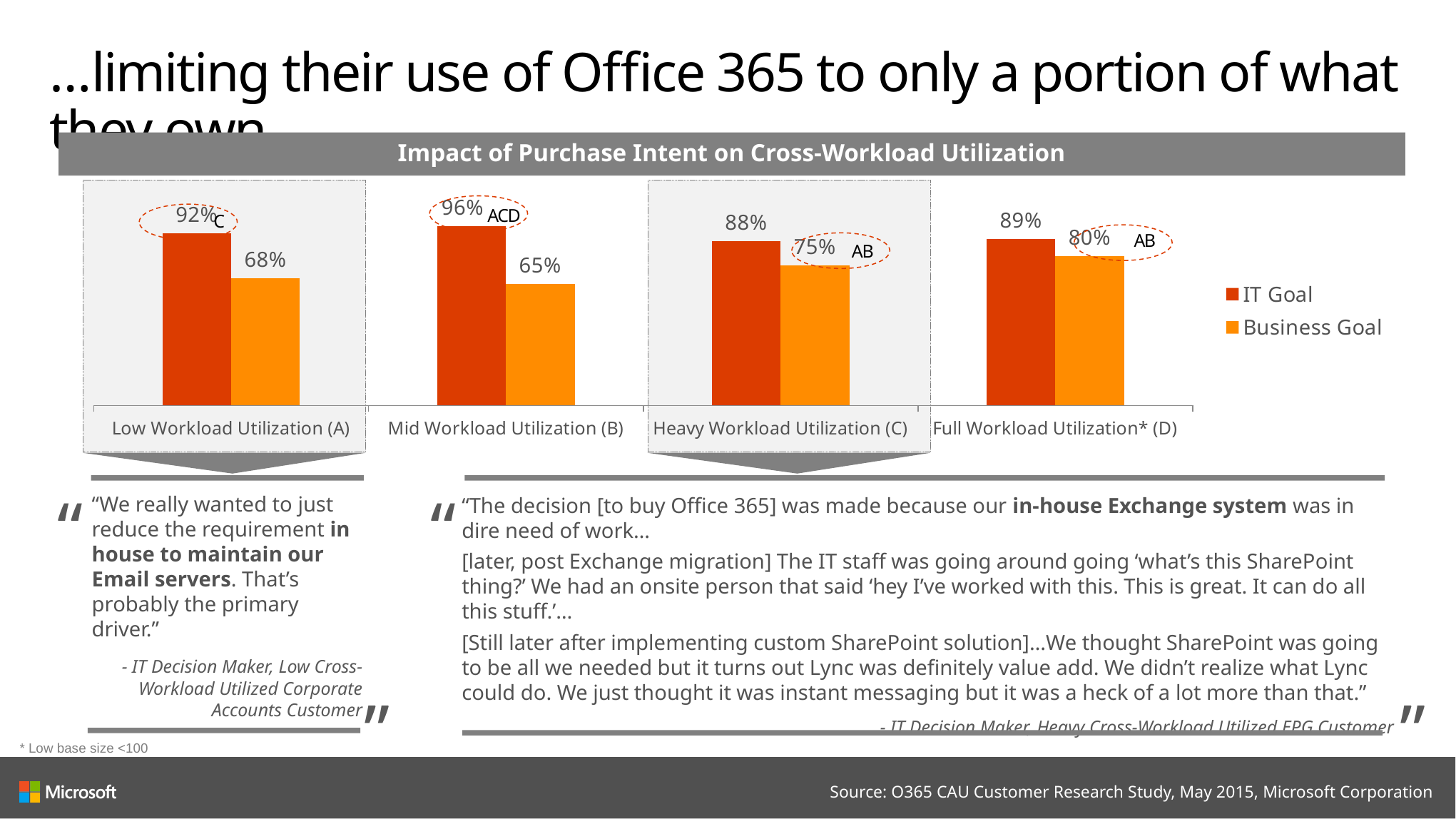
What is the IT Goal value for Low Workload Utilization (A)? 92% How many series does the legend list? 2 Which is larger: the Business Goal value for Full Workload Utilization* (D) or the Business Goal value for Low Workload Utilization (A)? Full Workload Utilization* (D) What is the difference between the IT Goal and Business Goal values for Mid Workload Utilization (B)? 31% What is the title of the chart? Impact of Purchase Intent on Cross-Workload Utilization What is the IT Goal value for Full Workload Utilization* (D)? 89% Which category has the highest IT Goal value? Mid Workload Utilization (B) Which category has the lowest Business Goal value? Mid Workload Utilization (B) What is the Business Goal value for Mid Workload Utilization (B)? 65% How many categories are shown on the x axis? 4 What is the Business Goal value for Heavy Workload Utilization (C)? 75% What kind of chart is shown on the slide? Bar chart